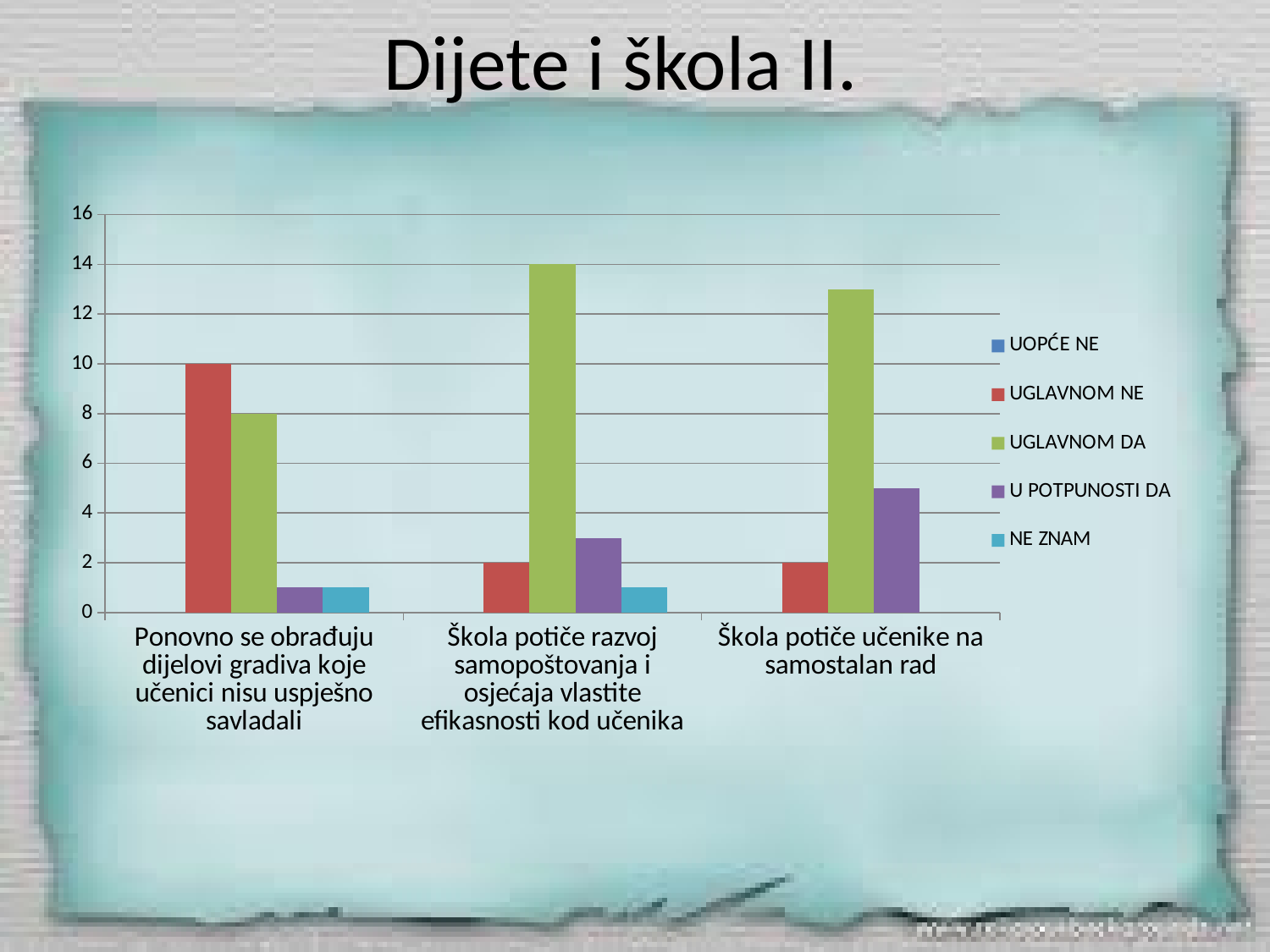
Is the value of UGLAVNOM DA for "Škola potiče učenike na samostalan rad" greater or less than 12? greater Which category has the highest UGLAVNOM NE value? Ponovno se obrađuju dijelovi gradiva koje učenici nisu uspješno savladali How many series does the legend list? 5 What is the value of UGLAVNOM NE for "Ponovno se obrađuju dijelovi gradiva koje učenici nisu uspješno savladali"? 10 How many categories are shown on the x axis? 3 What is the value of UGLAVNOM NE for "Škola potiče učenike na samostalan rad"? 2 What kind of chart is shown on the slide? bar chart What is the difference between the UGLAVNOM NE and UGLAVNOM DA values for "Ponovno se obrađuju dijelovi gradiva koje učenici nisu uspješno savladali"? 2 Which category has the highest UGLAVNOM DA value? Škola potiče razvoj samopoštovanja i osjećaja vlastite efikasnosti kod učenika What is the value of UGLAVNOM DA for "Ponovno se obrađuju dijelovi gradiva koje učenici nisu uspješno savladali"? 8 What is the value of UGLAVNOM DA for "Škola potiče razvoj samopoštovanja i osjećaja vlastite efikasnosti kod učenika"? 14 Is the value of U POTPUNOSTI DA for "Škola potiče učenike na samostalan rad" greater or less than 4? greater